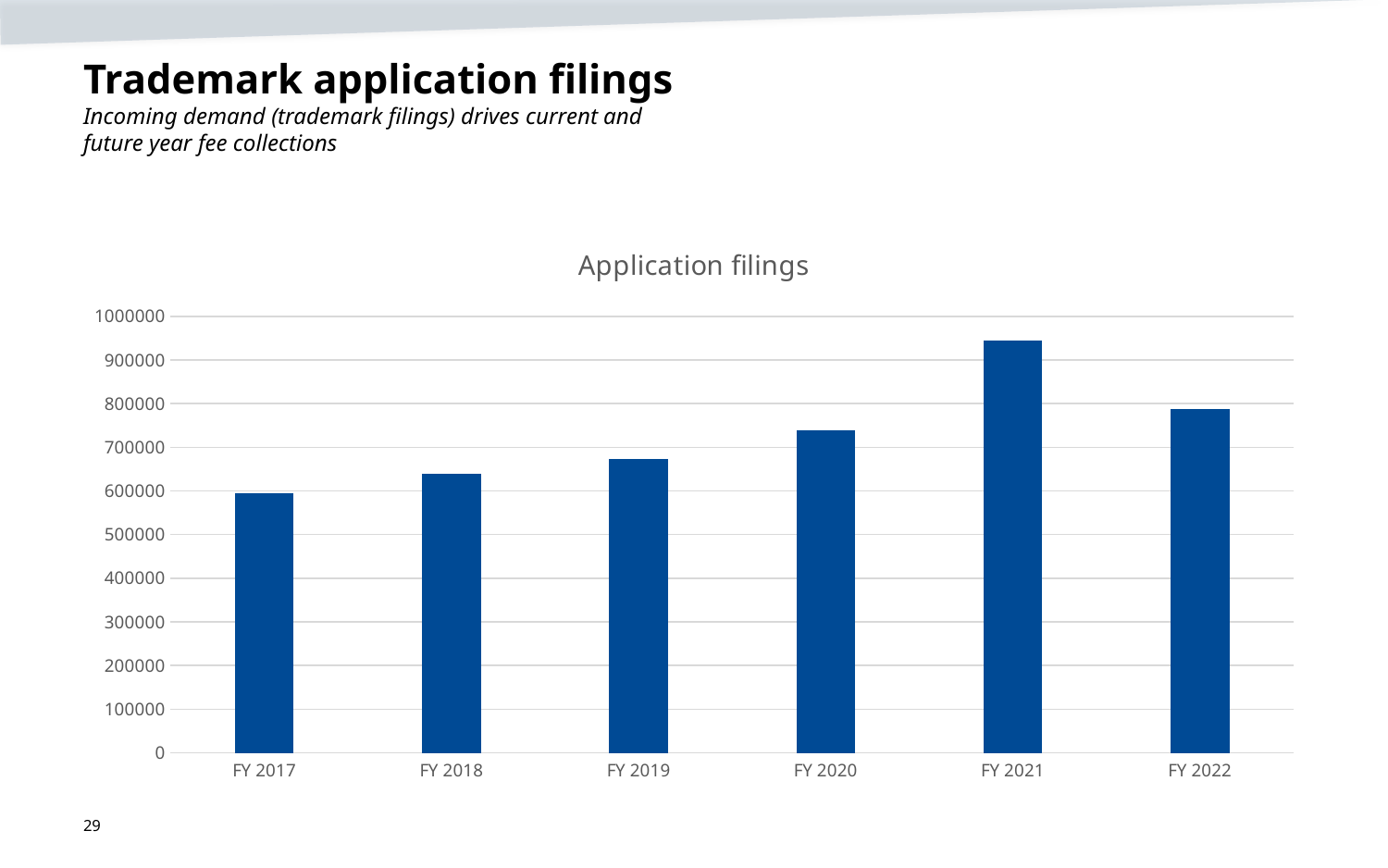
Which is larger, the value for FY 2018 or the value for FY 2021? FY 2021 How many fiscal years are shown on the x axis of the chart? 6 Which fiscal year has the lowest number of application filings? FY 2017 Is the value for FY 2021 greater or less than 900000? greater Is the value for FY 2018 greater or less than 700000? less What kind of chart is shown on the slide? bar chart Is the value for FY 2017 greater or less than 500000? greater Which fiscal year has the highest number of application filings? FY 2021 Which is larger, the value for FY 2020 or the value for FY 2022? FY 2022 Do the values rise or fall from FY 2017 to FY 2021? rise What is the title of the chart? Application filings